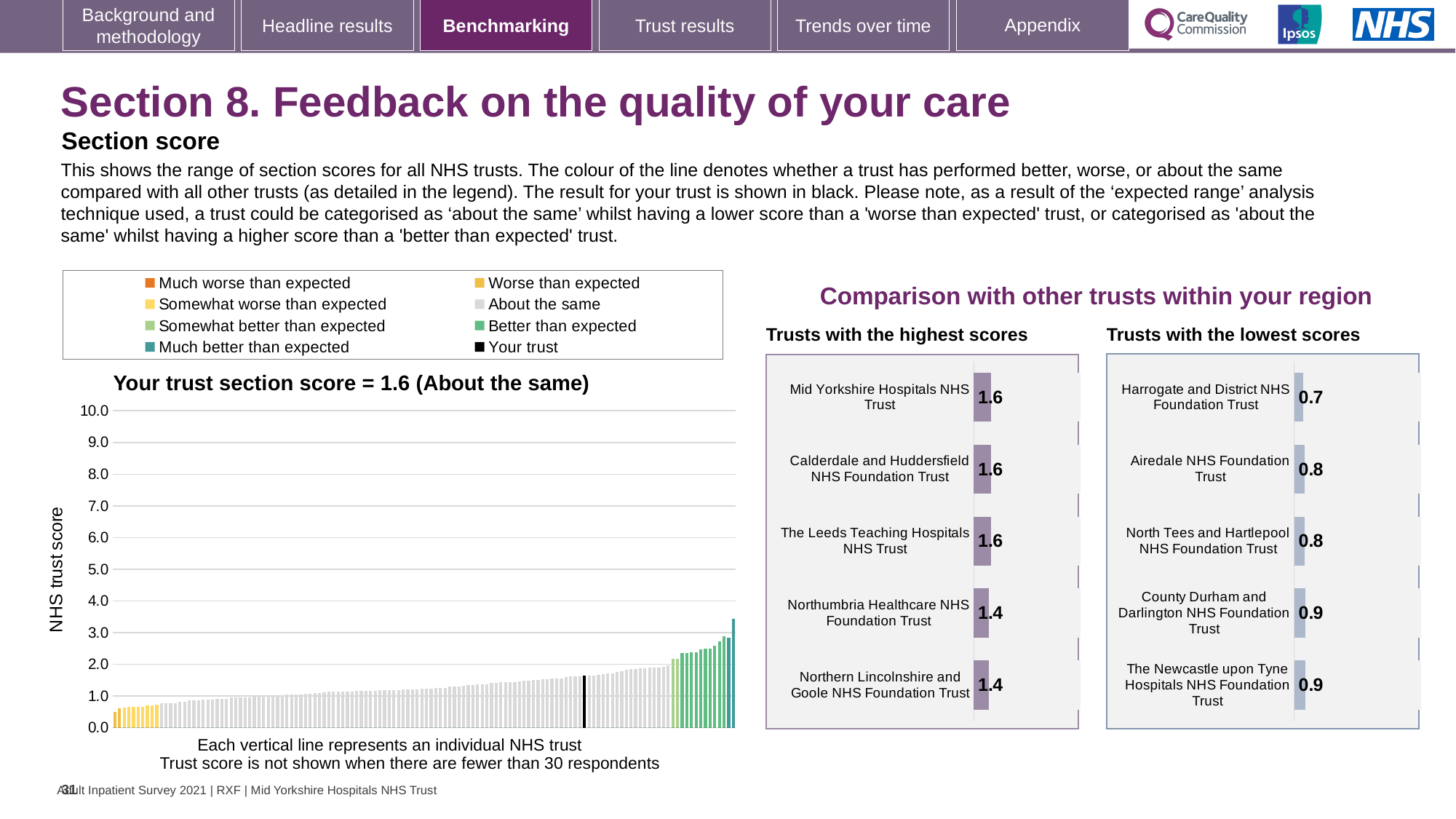
On the 'Your trust section score' chart, is the value of the tallest bar greater or less than 4.0? less How many entries does the legend above the 'Your trust section score' chart list? 8 On the 'Trusts with the lowest scores' chart, which trust has the lowest score? Harrogate and District NHS Foundation Trust On the 'Trusts with the lowest scores' chart, what is the score for Airedale NHS Foundation Trust? 0.8 On the 'Your trust section score' chart, what is the label of the y axis? NHS trust score How many trusts are shown on the 'Trusts with the highest scores' chart? 5 On the 'Your trust section score' chart, what is the section score for your trust? 1.6 What kind of chart is the 'Your trust section score' chart? bar chart On the 'Trusts with the lowest scores' chart, which has the larger score: Airedale NHS Foundation Trust or County Durham and Darlington NHS Foundation Trust? County Durham and Darlington NHS Foundation Trust On the 'Trusts with the highest scores' chart, what is the score for Northumbria Healthcare NHS Foundation Trust? 1.4 On the 'Trusts with the highest scores' chart, what is the difference between the scores of Mid Yorkshire Hospitals NHS Trust and Northern Lincolnshire and Goole NHS Foundation Trust? 0.2 On the 'Your trust section score' chart, do the trust scores rise or fall from left to right along the x axis? rise